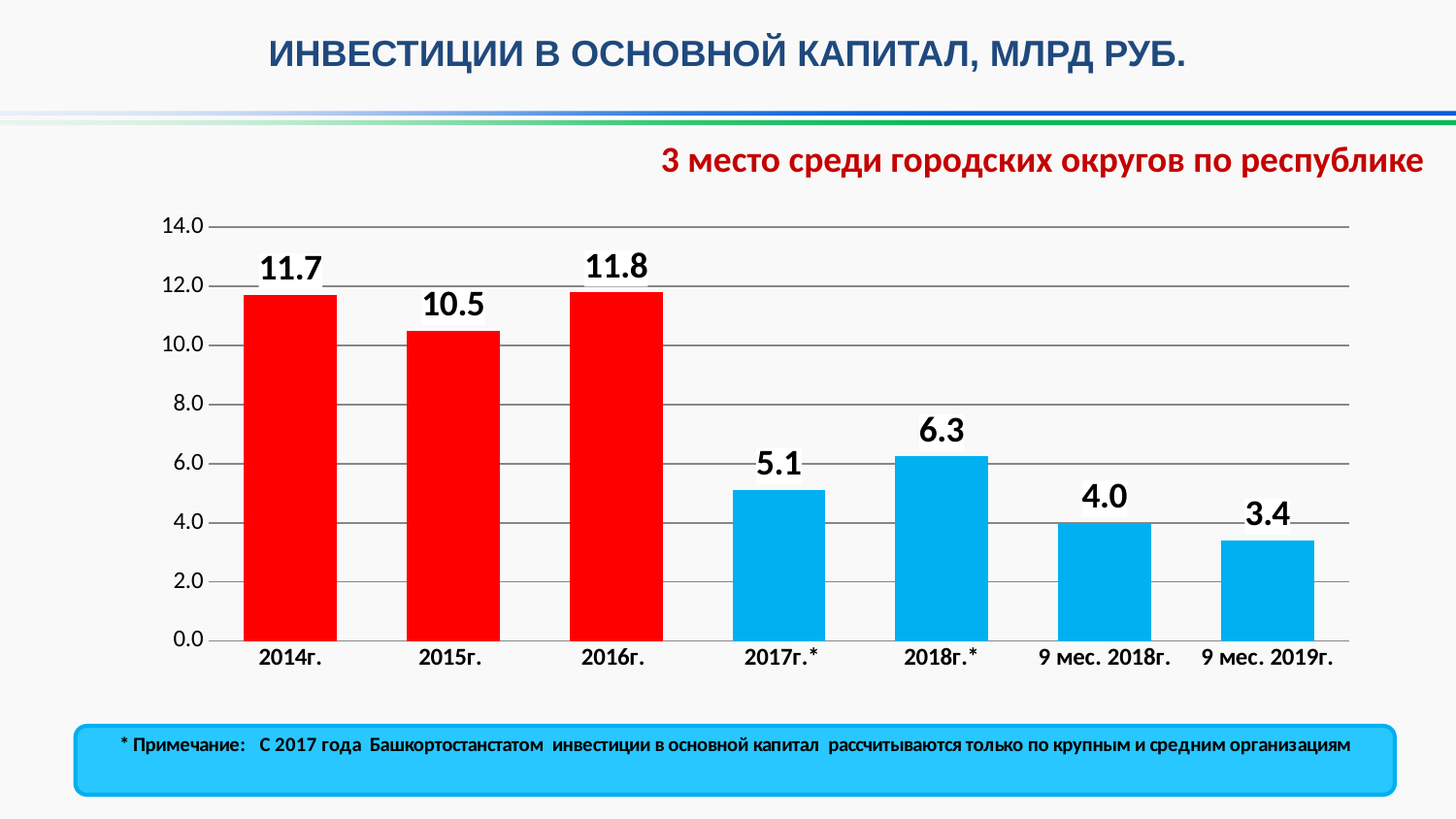
What kind of chart is shown on the slide? bar chart Which category has the lowest value? 9 мес. 2019г. Which is larger, the value for 2017г.* or the value for 2018г.*? 2018г.* What is the difference between the values for 9 мес. 2018г. and 9 мес. 2019г.? 0.6 Is the value for 2015г. greater or less than 10.0? greater What is the value for 9 мес. 2019г.? 3.4 What is the difference between the values for 2016г. and 2015г.? 1.3 Which category has the highest value? 2016г. How many categories are shown on the x axis? 7 What is the value for 2014г.? 11.7 What is the title of the chart? ИНВЕСТИЦИИ В ОСНОВНОЙ КАПИТАЛ, МЛРД РУБ. What is the value for 2018г.*? 6.3